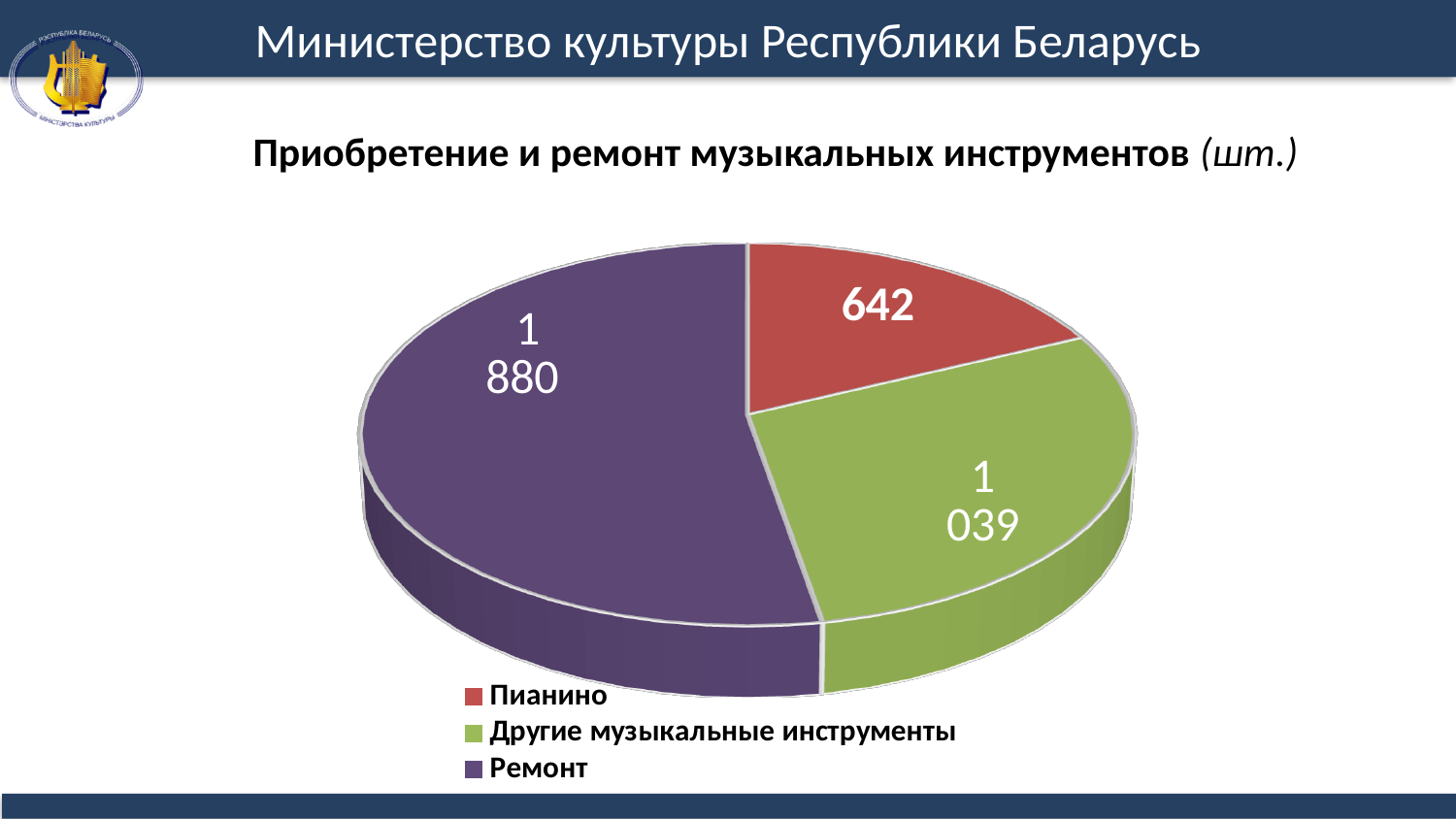
What kind of chart is shown on the slide? Pie chart What value is shown for Пианино? 642 What value is shown for Ремонт? 1 880 What is the difference between the values for Другие музыкальные инструменты and Пианино? 397 What is the title of the chart? Приобретение и ремонт музыкальных инструментов (шт.) How many entries does the legend list? 3 Which category has the largest slice of the pie? Ремонт What value is shown for Другие музыкальные инструменты? 1 039 How many slices does the pie chart have? 3 Which category has the smallest slice of the pie? Пианино What is the difference between the values for Ремонт and Пианино? 1 238 Which is larger, the value for Ремонт or the value for Другие музыкальные инструменты? Ремонт